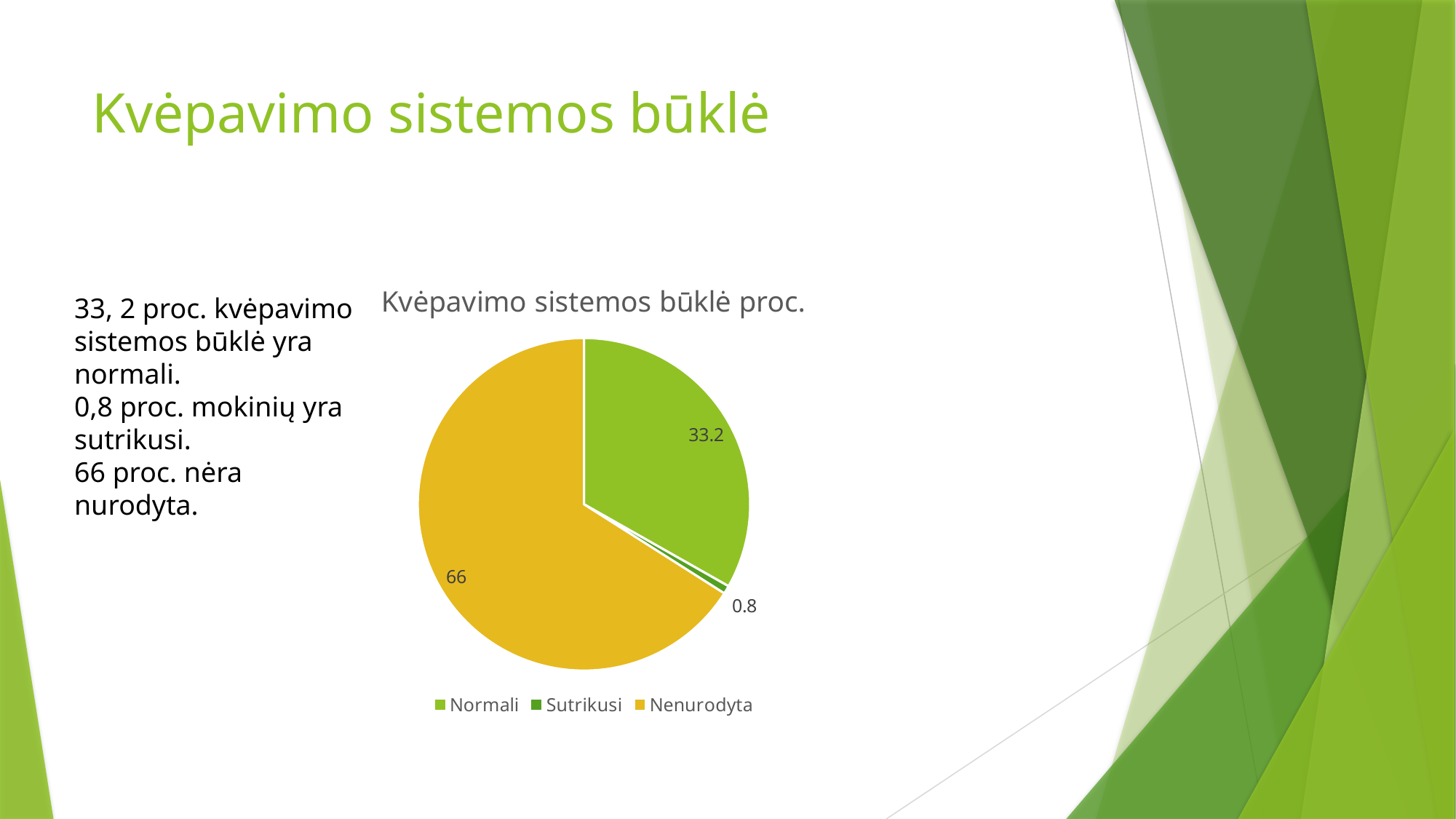
Which category has the largest slice in the pie chart? Nenurodyta How many categories does the pie chart show? 3 What is the value for Normali in the pie chart? 33.2 What is the value for Sutrikusi in the pie chart? 0.8 What is the value for Nenurodyta in the pie chart? 66 What kind of chart is shown on the slide? Pie chart What is the difference between the values for Normali and Sutrikusi? 32.4 Which category is shown in yellow in the pie chart? Nenurodyta What is the difference between the values for Nenurodyta and Normali? 32.8 Which is larger, the value for Normali or the value for Nenurodyta? Nenurodyta Which category has the smallest slice in the pie chart? Sutrikusi What is the title of the chart? Kvėpavimo sistemos būklė proc.